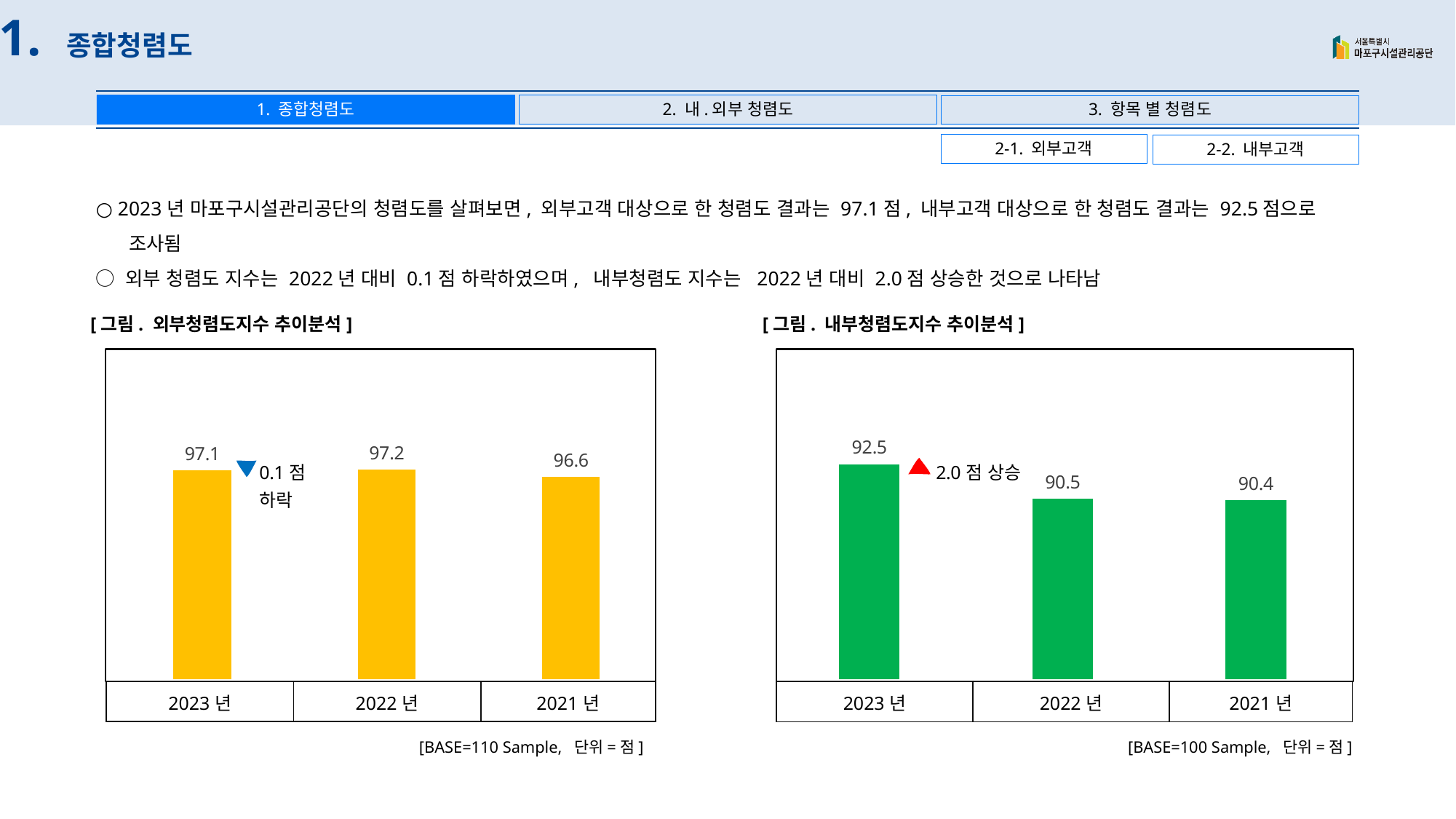
In the left chart (외부청렴도지수 추이분석), what is the value for 2021 년? 96.6 How many bars are in the right chart (내부청렴도지수 추이분석)? 3 In the left chart (외부청렴도지수 추이분석), what is the difference between the 2022 년 and 2021 년 values? 0.6 In the left chart (외부청렴도지수 추이분석), what is the value for 2023 년? 97.1 What colour are the bars in the right chart (내부청렴도지수 추이분석)? Green In the right chart (내부청렴도지수 추이분석), what is the difference between the 2023 년 and 2022 년 values? 2.0 In the left chart (외부청렴도지수 추이분석), which is larger, the value for 2023 년 or 2021 년? 2023 년 In the right chart (내부청렴도지수 추이분석), what is the value for 2022 년? 90.5 In the right chart (내부청렴도지수 추이분석), do the values rise or fall moving left to right along the x axis from 2023 년 to 2021 년? Fall In the left chart (외부청렴도지수 추이분석), which year has the lowest value? 2021 년 In the right chart (내부청렴도지수 추이분석), which year has the highest value? 2023 년 What type of chart is the left chart (외부청렴도지수 추이분석)? Bar chart